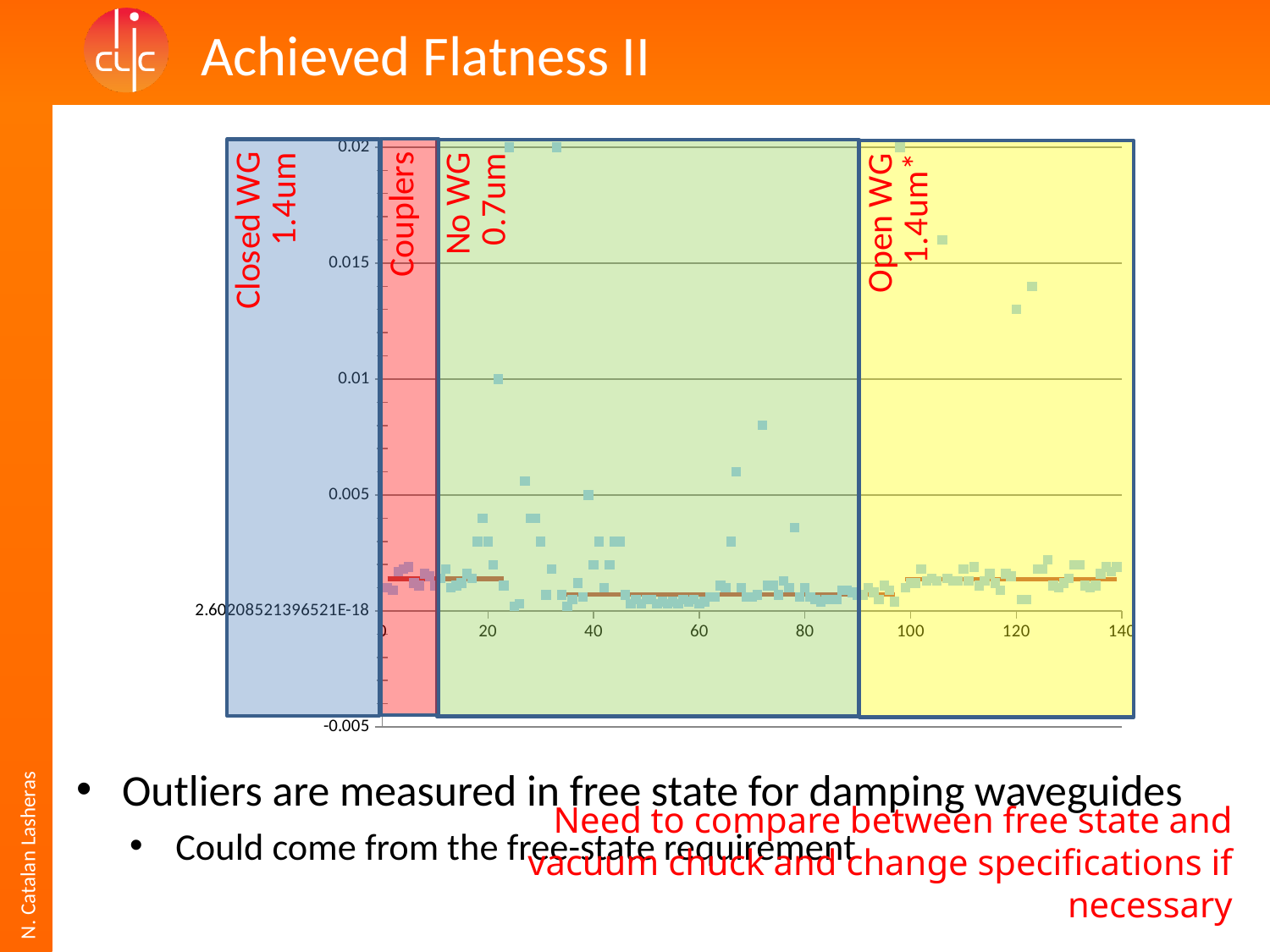
What is the label of the red shaded region in the chart? Couplers What is the lowest tick value shown on the y axis of the chart? -0.005 Are the points in the Couplers region greater or less than 0.005? less Are the highest points in the No WG 0.7um region greater or less than 0.015? greater What is the largest tick value shown on the x axis of the chart? 140 What is the label of the yellow shaded region on the right of the chart? Open WG 1.4um* How many labelled regions (shaded bands) does the chart divide the data into? 4 What kind of chart is shown on the slide? scatter chart What is the highest tick value shown on the y axis of the chart? 0.02 Are the highest points in the Open WG 1.4um* region greater or less than 0.01? greater Which region contains the points with the highest values on the chart, Couplers or No WG 0.7um? No WG 0.7um